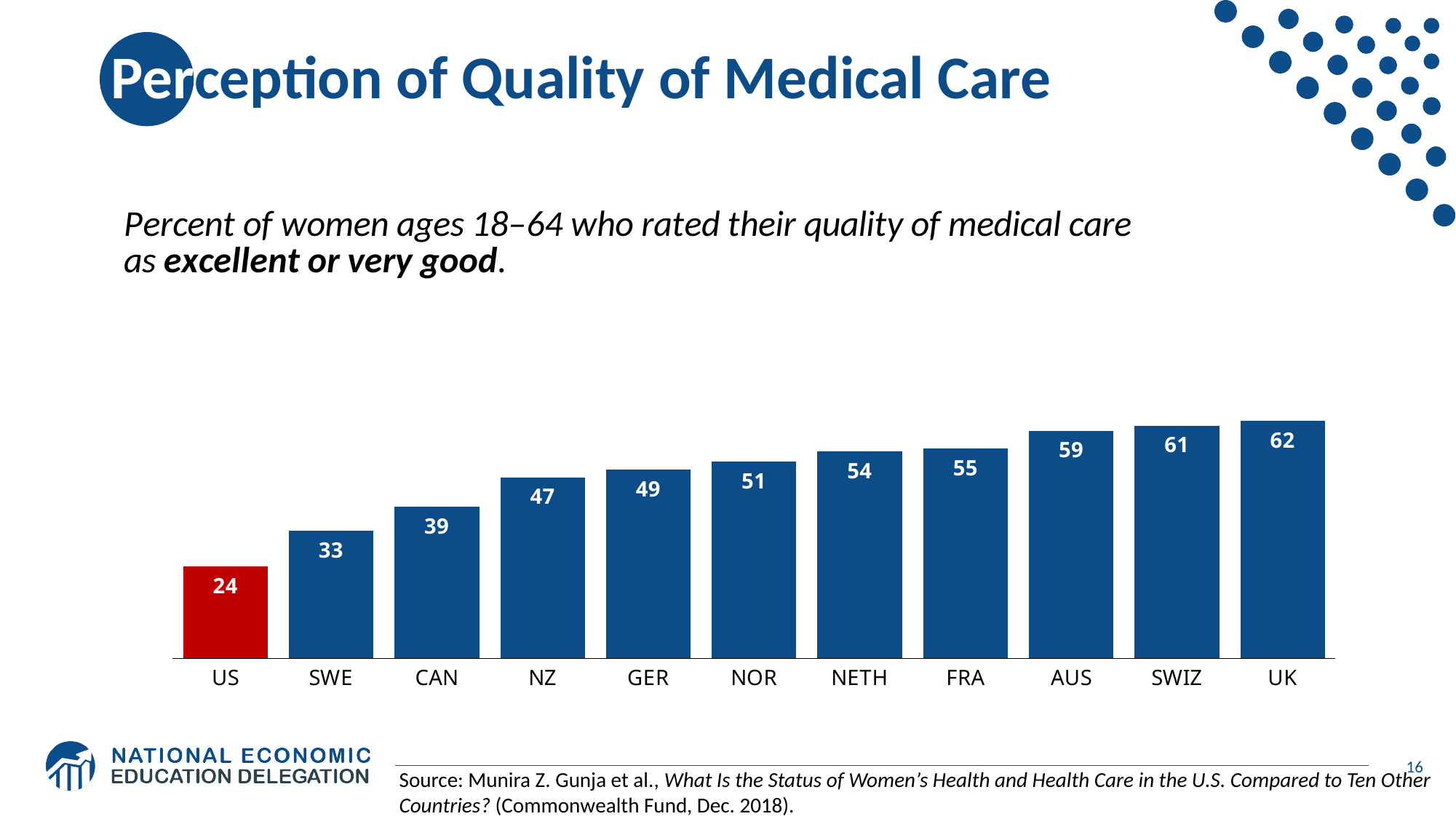
What is the value for the US? 24 How many countries are shown in the chart? 11 What is the difference between the values for CAN and SWE? 6 What kind of chart is shown on the slide? Bar chart What is the value for AUS? 59 What is the value for GER? 49 Do the values rise or fall from left to right across the chart? Rise Which has a larger value, NOR or NZ? NOR What is the difference between the values for UK and US? 38 Which bar is coloured red rather than blue? US Which country has the lowest value? US Which country has the highest value? UK